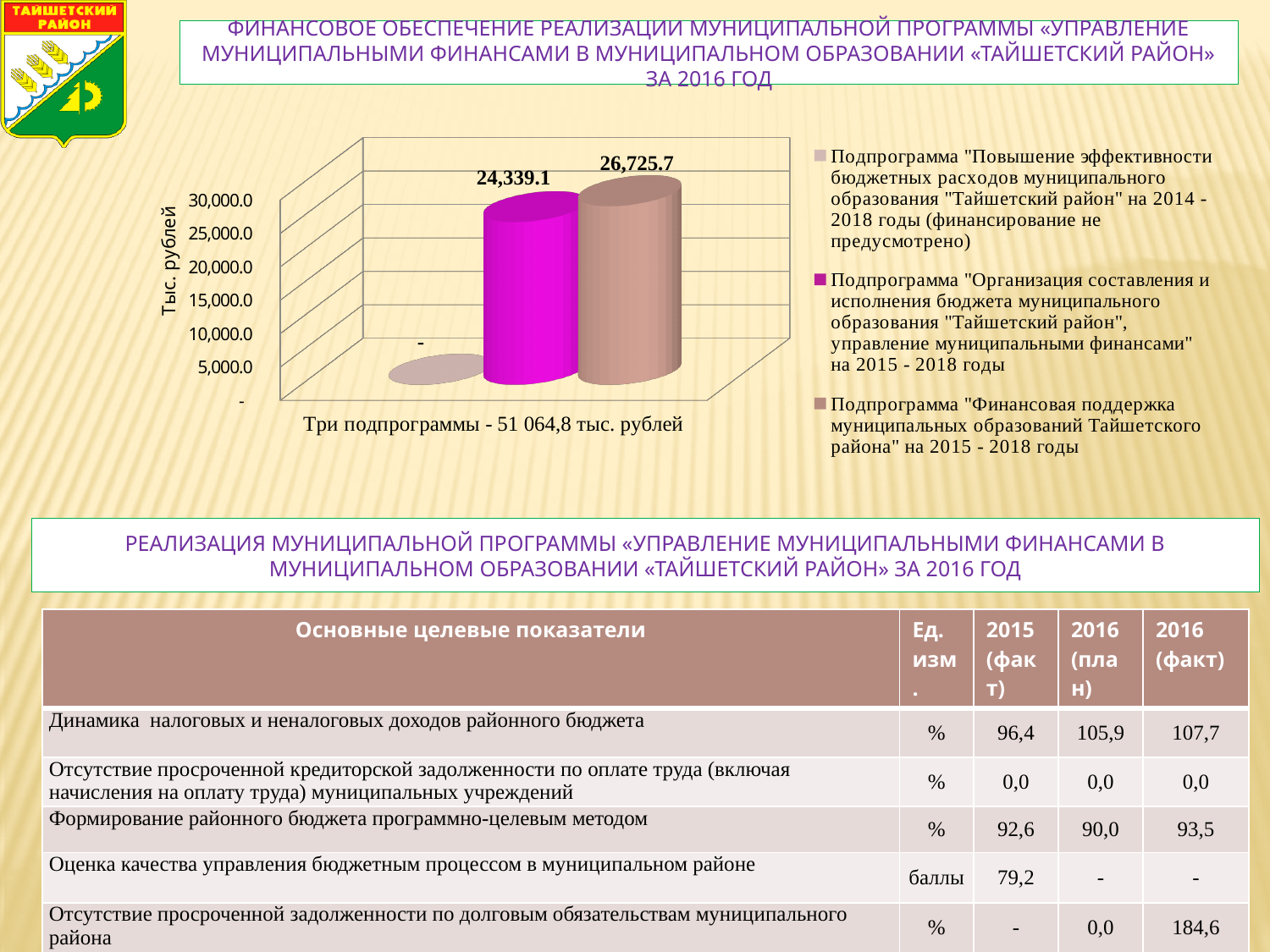
Is the value for the subprogram "Финансовая поддержка муниципальных образований Тайшетского района" greater or less than 25,000.0? greater Which subprogram is shown in magenta in the chart? Подпрограмма "Организация составления и исполнения бюджета муниципального образования "Тайшетский район", управление муниципальными финансами" на 2015 - 2018 годы Which subprogram has the highest value in the chart? Подпрограмма "Финансовая поддержка муниципальных образований Тайшетского района" на 2015 - 2018 годы What total for the three subprograms is stated in the caption below the chart? 51 064,8 тыс. рублей What type of chart is shown on the slide? Bar chart How many series does the chart legend list? 3 Which subprogram has no funding shown in the chart (value "-")? Подпрограмма "Повышение эффективности бюджетных расходов муниципального образования "Тайшетский район" на 2014 - 2018 годы What is the value for the subprogram "Организация составления и исполнения бюджета муниципального образования "Тайшетский район", управление муниципальными финансами" на 2015 - 2018 годы? 24,339.1 Which is larger: the value for the subprogram "Организация составления и исполнения бюджета..." or the value for the subprogram "Финансовая поддержка муниципальных образований..."? Подпрограмма "Финансовая поддержка муниципальных образований Тайшетского района" на 2015 - 2018 годы What is the value for the subprogram "Финансовая поддержка муниципальных образований Тайшетского района" на 2015 - 2018 годы? 26,725.7 What is the difference between the values 26,725.7 and 24,339.1 shown in the chart? 2,386.6 What is the label of the vertical axis of the chart? Тыс. рублей